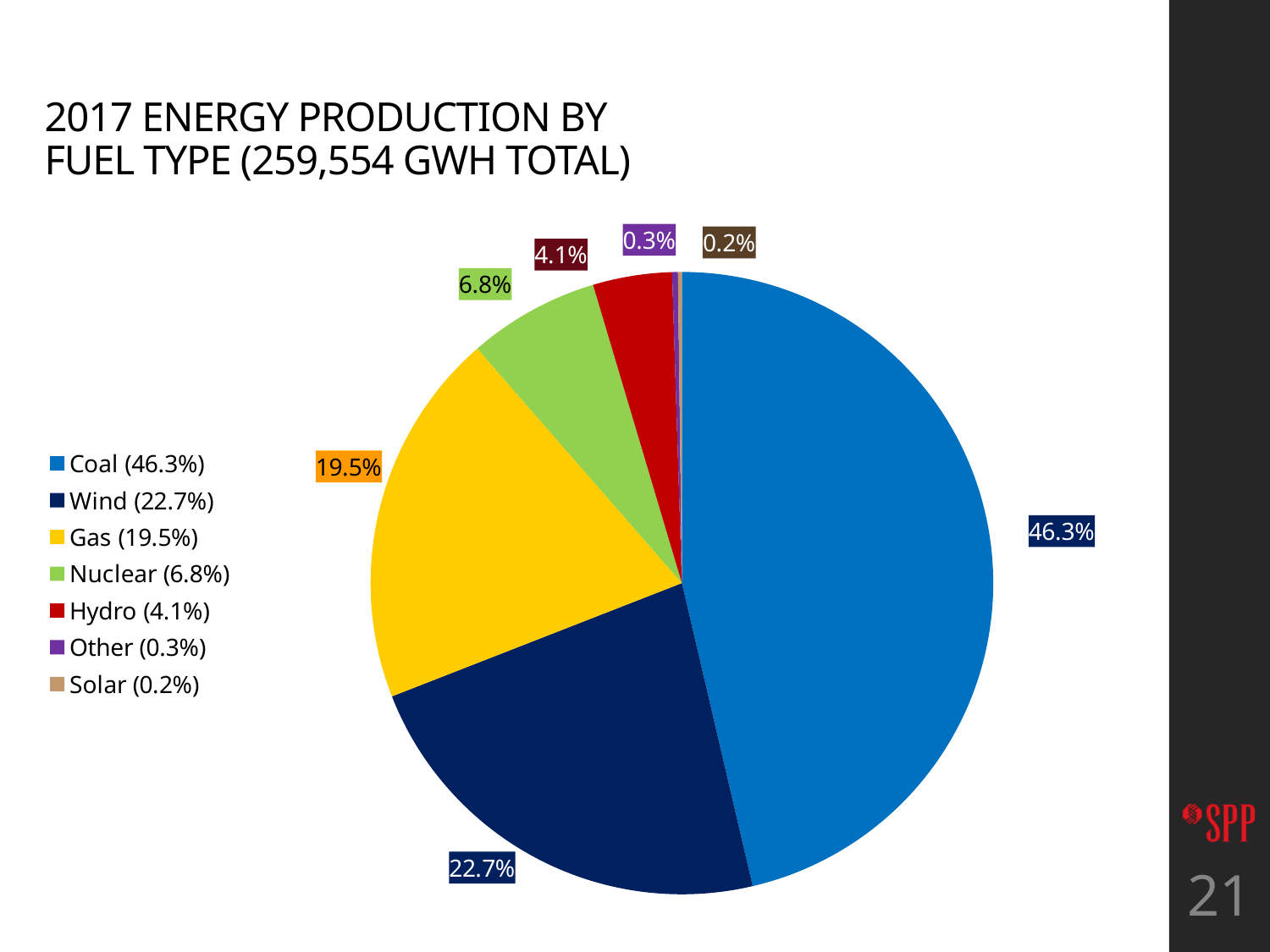
What percentage does the Gas slice represent? 19.5% What share of 2017 energy production came from Wind? 22.7% What is the difference in percentage points between the Coal and Wind shares? 23.6 Which fuel type has the largest share of energy production? Coal What share of 2017 energy production came from Coal? 46.3% What type of chart is shown on the slide? Pie chart What is the share for Hydro? 4.1% What percentage does the Nuclear slice represent? 6.8% What total energy production is stated in the chart title? 259,554 GWH Which fuel type has the smallest share of energy production? Solar How many fuel types are shown in the pie chart? 7 Which has a larger share, Gas or Nuclear? Gas